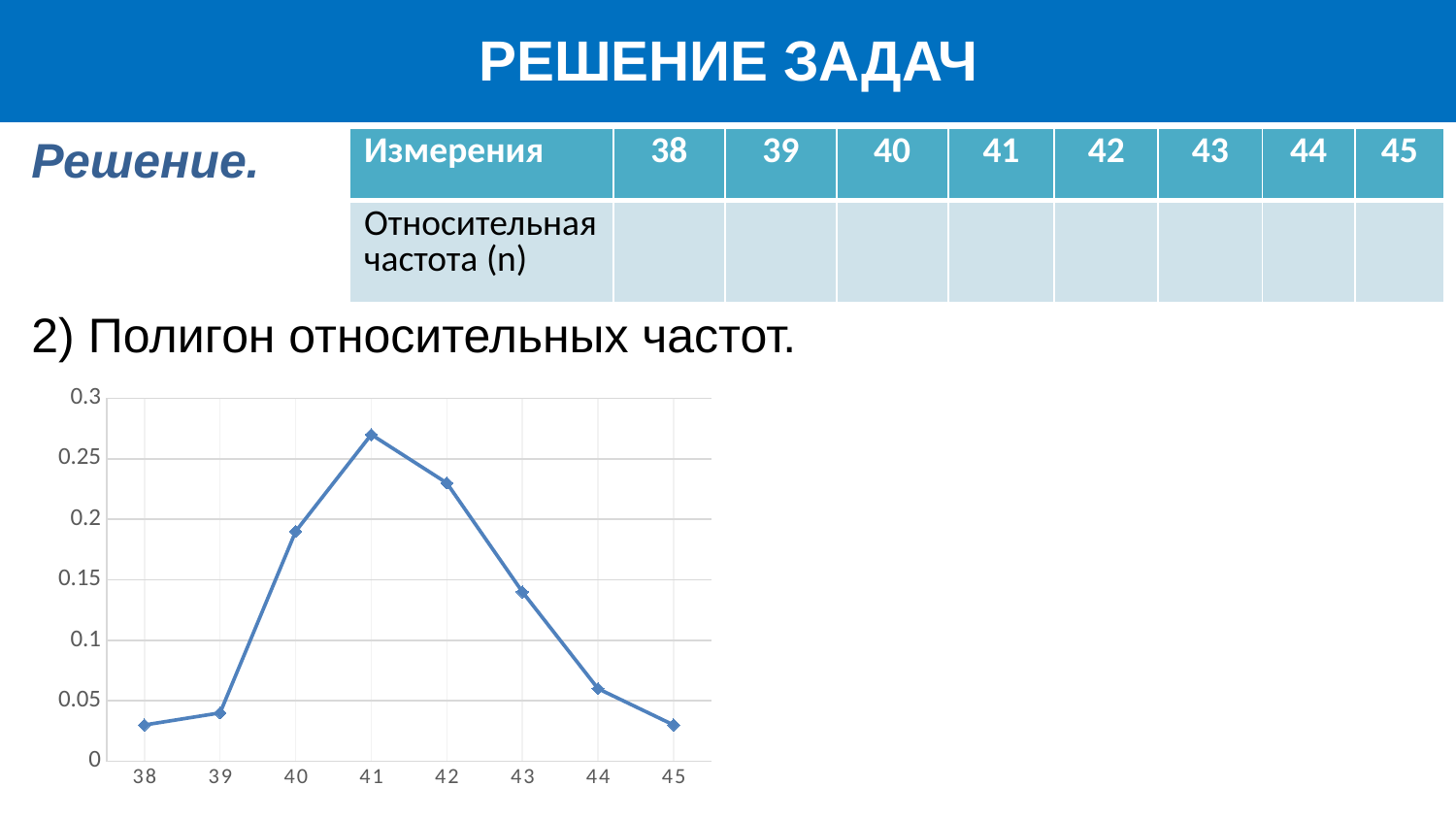
Is the value at 43 greater or less than 0.15? less Which has the larger value, 42 or 44? 42 Which x-axis value has the highest point on the chart? 41 Is the value at 41 greater or less than 0.25? greater Is the value at 40 greater or less than 0.2? less Do the values rise or fall along the x axis from 41 to 45? fall Which has the larger value, 40 or 43? 40 What kind of chart is shown on the slide? line chart How many data points are plotted on the chart? 8 What is the highest tick value shown on the vertical axis? 0.3